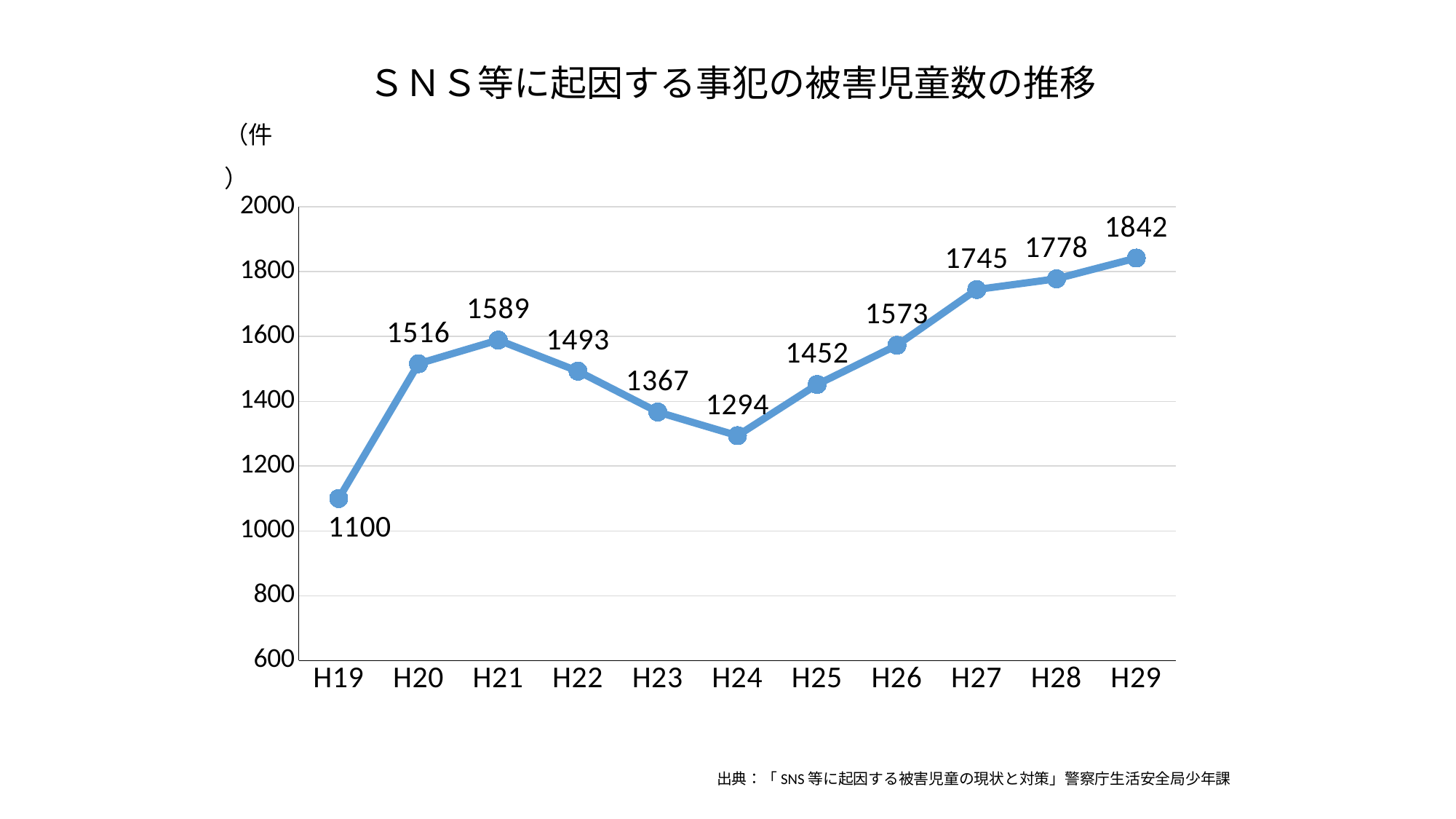
What is the difference between the values for H21 and H24? 295 Which is larger, the value for H21 or the value for H26? H21 What is the difference between the values for H29 and H19? 742 What is the value for H24? 1294 How many data points are plotted on the chart? 11 What is the value for H29? 1842 What is the value for H19? 1100 What is the title of the chart? ＳＮＳ等に起因する事犯の被害児童数の推移 Do the values rise or fall from H24 to H29? Rise Which year has the lowest value? H19 Which year has the highest value? H29 What kind of chart is shown on the slide? Line chart